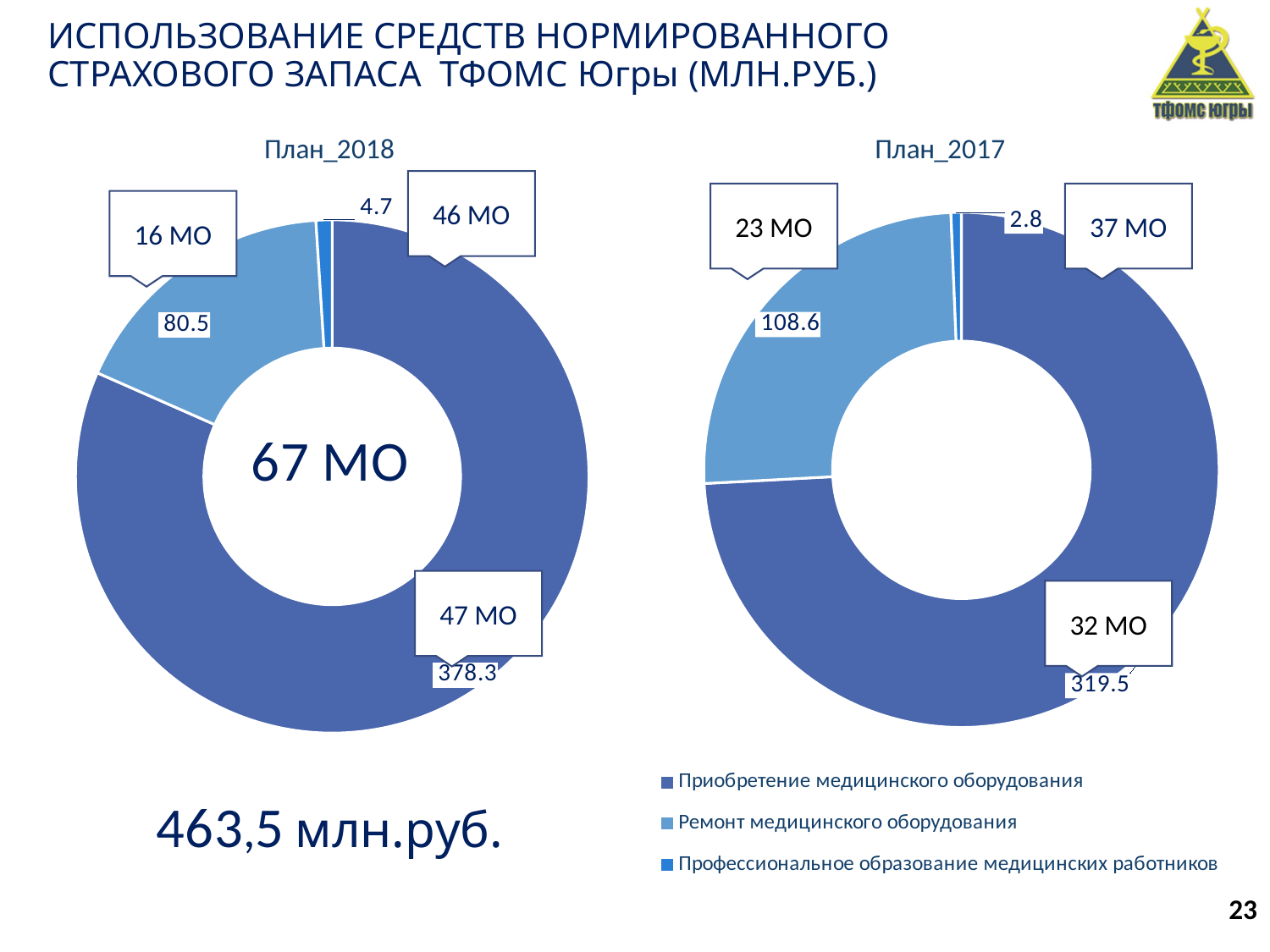
What total amount in млн.руб. is printed below the План_2018 chart? 463,5 млн.руб. In the План_2017 chart, which category has the largest value? Приобретение медицинского оборудования In the План_2017 chart, what is the value for Профессиональное образование медицинских работников? 2.8 What is the difference between the Приобретение медицинского оборудования value in План_2018 and in План_2017? 58.8 How many categories does the legend list for the charts? 3 In the План_2018 chart, what is the value for Приобретение медицинского оборудования? 378.3 What type of chart is used for План_2018 and План_2017? Doughnut (pie) chart In the План_2017 chart, what is the value for Ремонт медицинского оборудования? 108.6 What is the total of the three values in the План_2017 chart? 430.9 In the План_2018 chart, which category has the smallest value? Профессиональное образование медицинских работников What is the difference between the Ремонт медицинского оборудования value in План_2017 and in План_2018? 28.1 Which is larger: Ремонт медицинского оборудования in План_2018 or in План_2017? План_2017